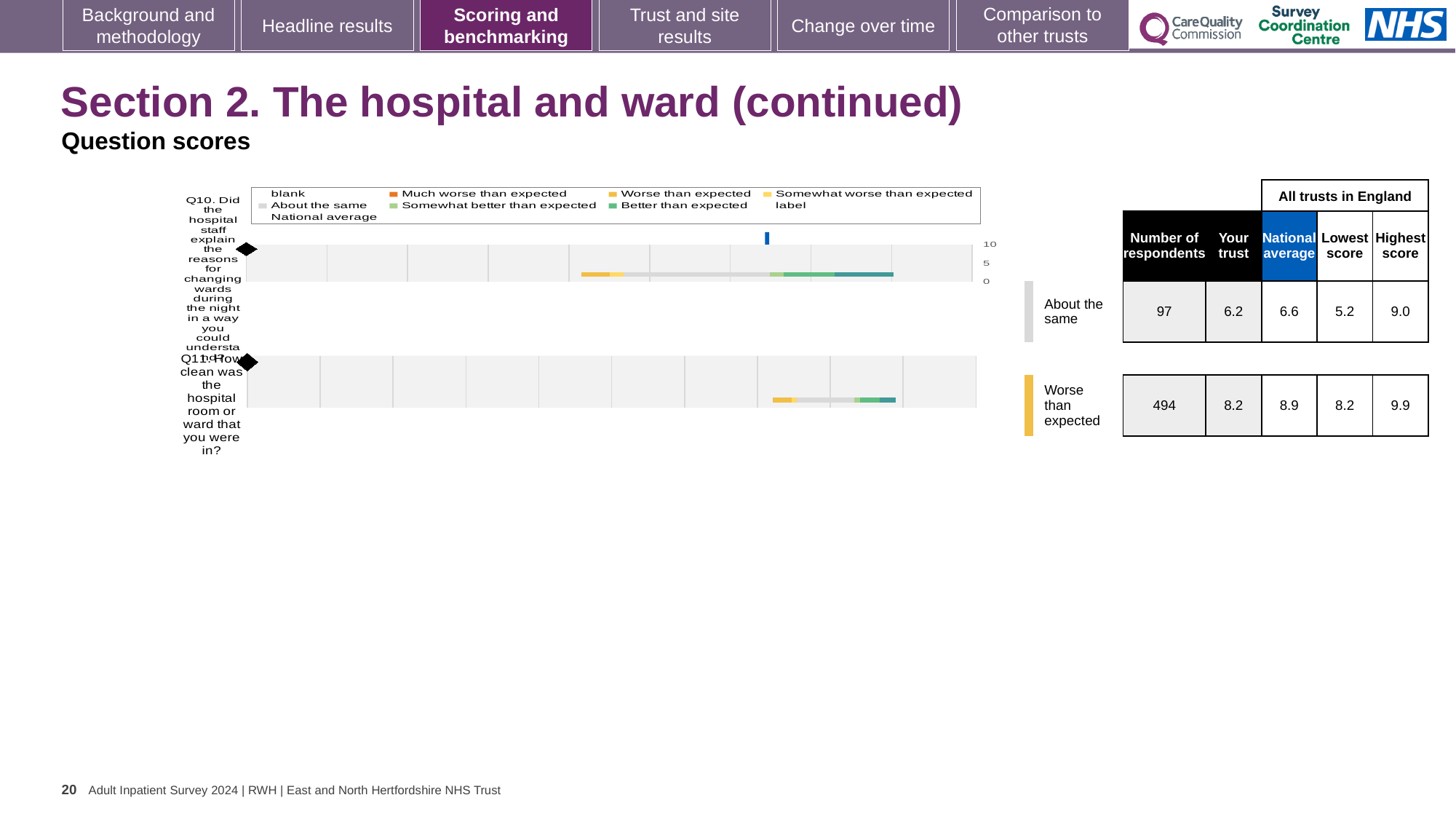
Which question has the higher 'Your trust' score, Q10 or Q11? Q11 What is the difference between the highest and lowest scores across all trusts in England for Q10? 3.8 What is the difference between the national average and the trust's score for Q11? 0.7 What is the 'Your trust' score for Q10 (explaining reasons for changing wards during the night)? 6.2 Which benchmarking category is the trust's Q10 score placed in? About the same What is the 'Your trust' score for Q11 (how clean was the hospital room or ward)? 8.2 Which benchmarking category is the trust's Q11 score placed in? Worse than expected How many survey questions are plotted on the chart? 2 Is the trust's score for Q10 greater or less than 5 on the chart's axis? greater How many respondents answered Q11? 494 What is the national average score for Q10? 6.6 What kind of chart is used to show the question scores for Q10 and Q11? bar chart